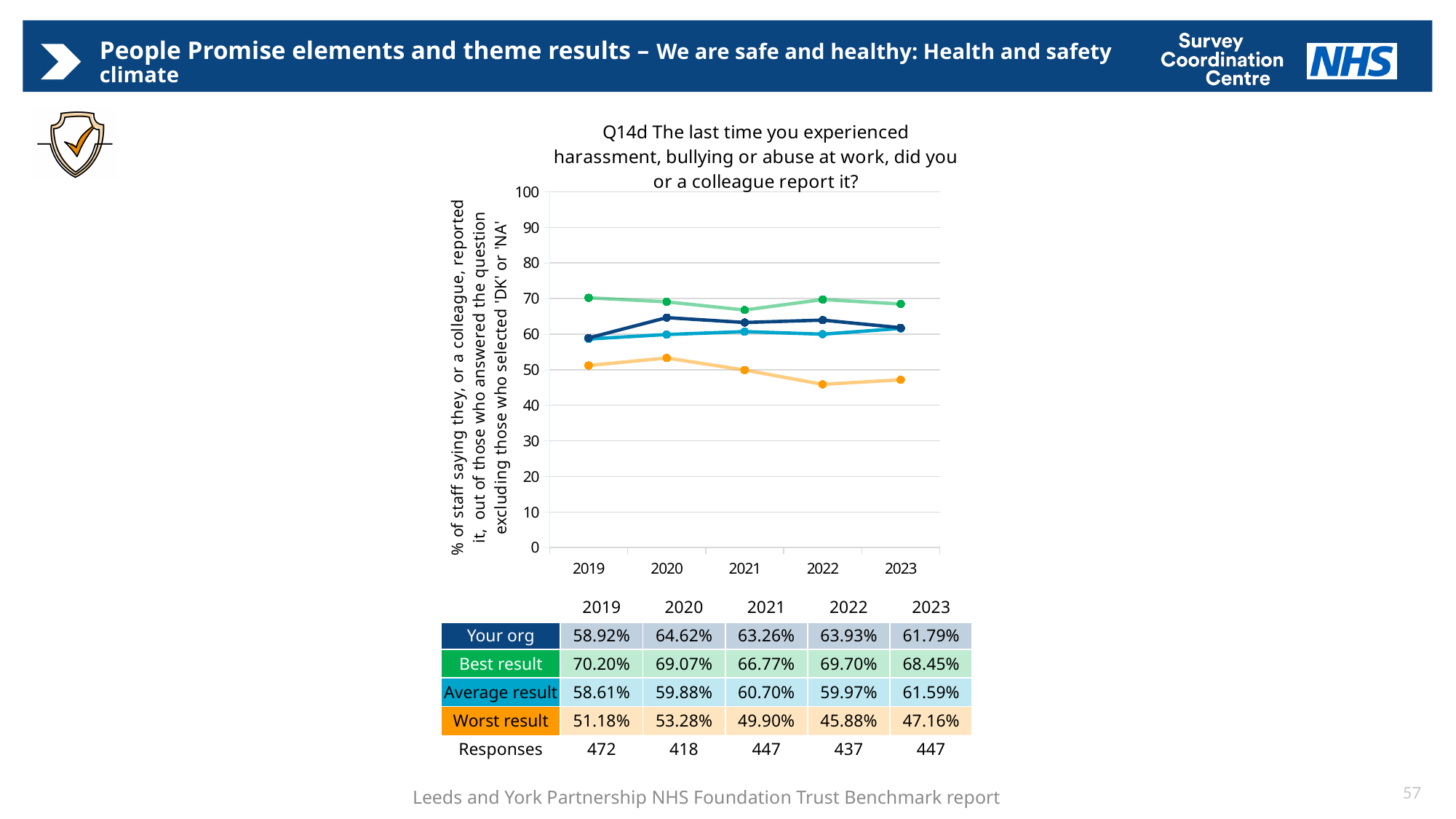
How many years are plotted along the x axis of the chart? 5 Which is larger in 2021: Your org or Average result? Your org In which year was the Worst result value lowest? 2022 What is the value for Your org in 2020? 64.62% What is the Worst result value in 2022? 45.88% What is the difference between the Best result and Your org values in 2023? 6.66% What is the Average result value in 2023? 61.59% How many series are plotted on the chart? 4 In which year was the Best result value highest? 2019 Is the Worst result value for 2020 greater or less than 60? less What kind of chart is shown on the slide? Line chart How many responses were recorded in 2019? 472